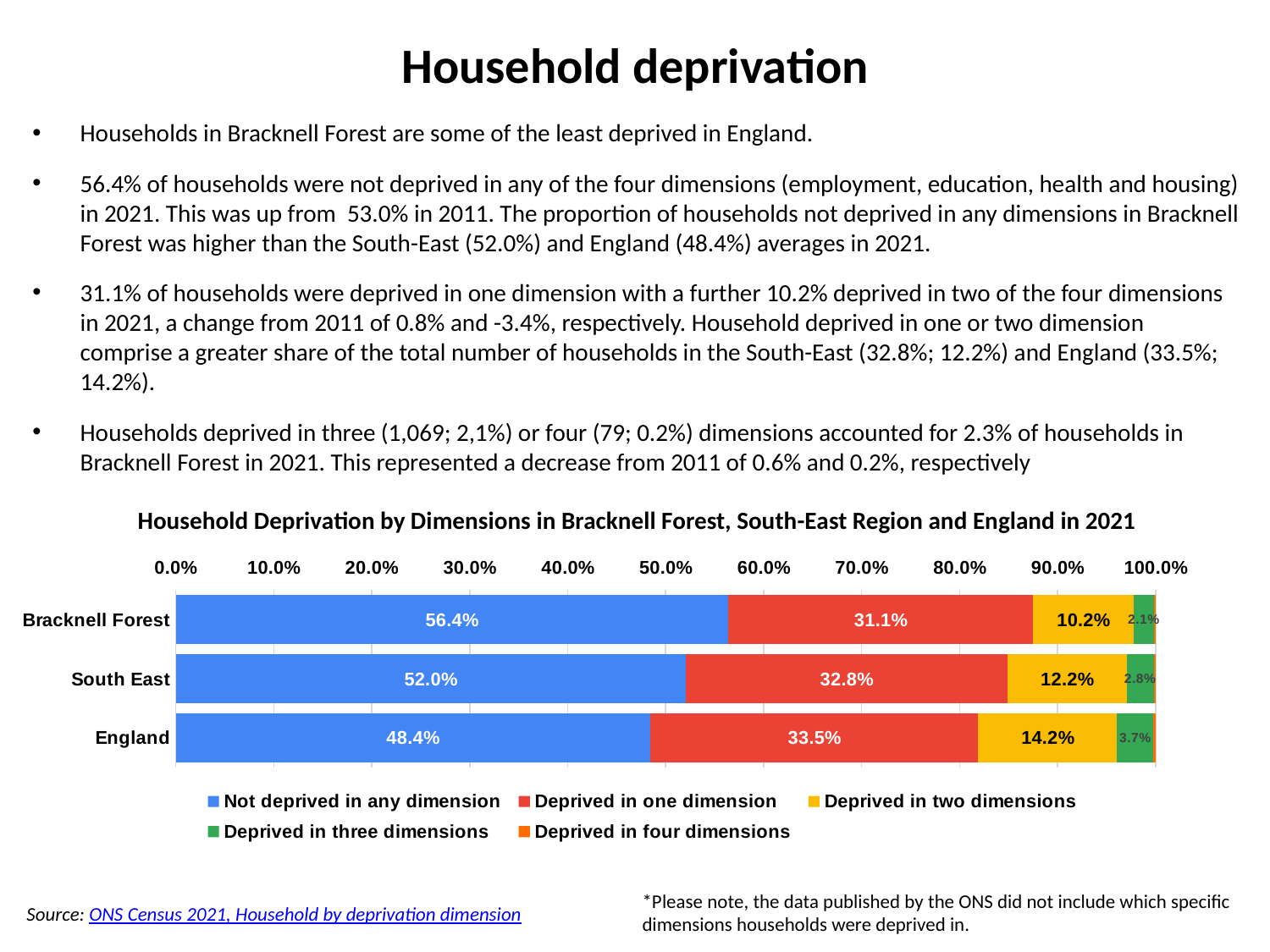
How many series does the legend list? 5 Which is larger: the share of households deprived in one dimension in the South East or in Bracknell Forest? South East What type of chart is shown on the slide? Stacked bar chart What percentage of households in Bracknell Forest are not deprived in any dimension? 56.4% Which area has the highest share of households not deprived in any dimension? Bracknell Forest How many areas are shown on the chart? 3 What percentage of households in England are deprived in three dimensions? 3.7% What is the difference between the share of households not deprived in any dimension in Bracknell Forest and in England? 8.0% Which area has the lowest share of households deprived in two dimensions? Bracknell Forest What percentage of households in England are deprived in one dimension? 33.5% What percentage of households in the South East are deprived in two dimensions? 12.2% What colour represents households deprived in two dimensions? Yellow